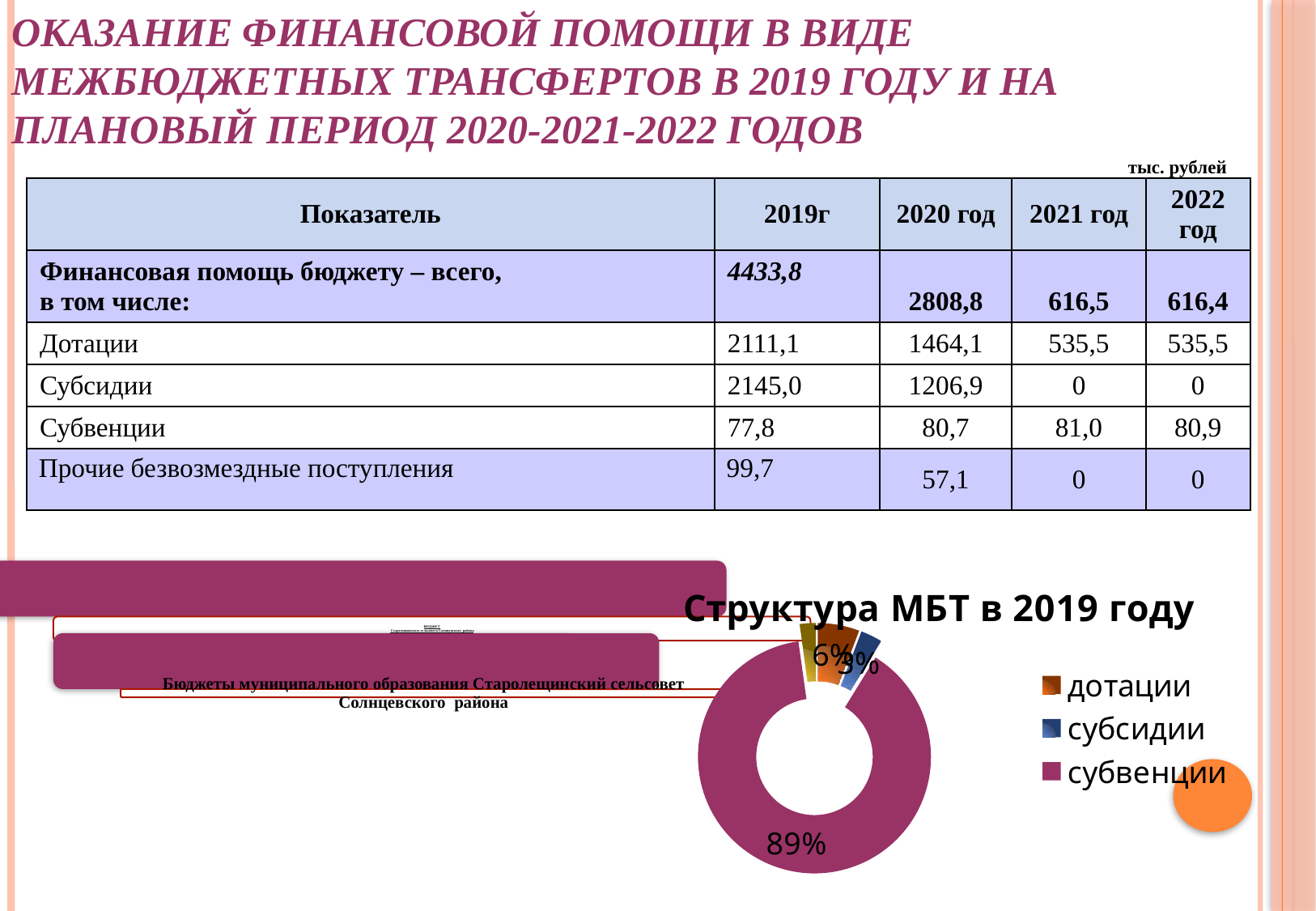
What share of the chart does субвенции account for? 89% How many entries does the chart's legend list? 3 Which is larger in the chart, the share for субвенции or the share for дотации? субвенции Which category has the largest share in the chart? субвенции What kind of chart is shown on the slide? pie chart (doughnut) Which legend entry is shown in blue in the chart? субсидии Is the share for субвенции greater or less than 50%? greater What is the title of the chart on the slide? Структура МБТ в 2019 году Is the share for дотации greater or less than 50%? less